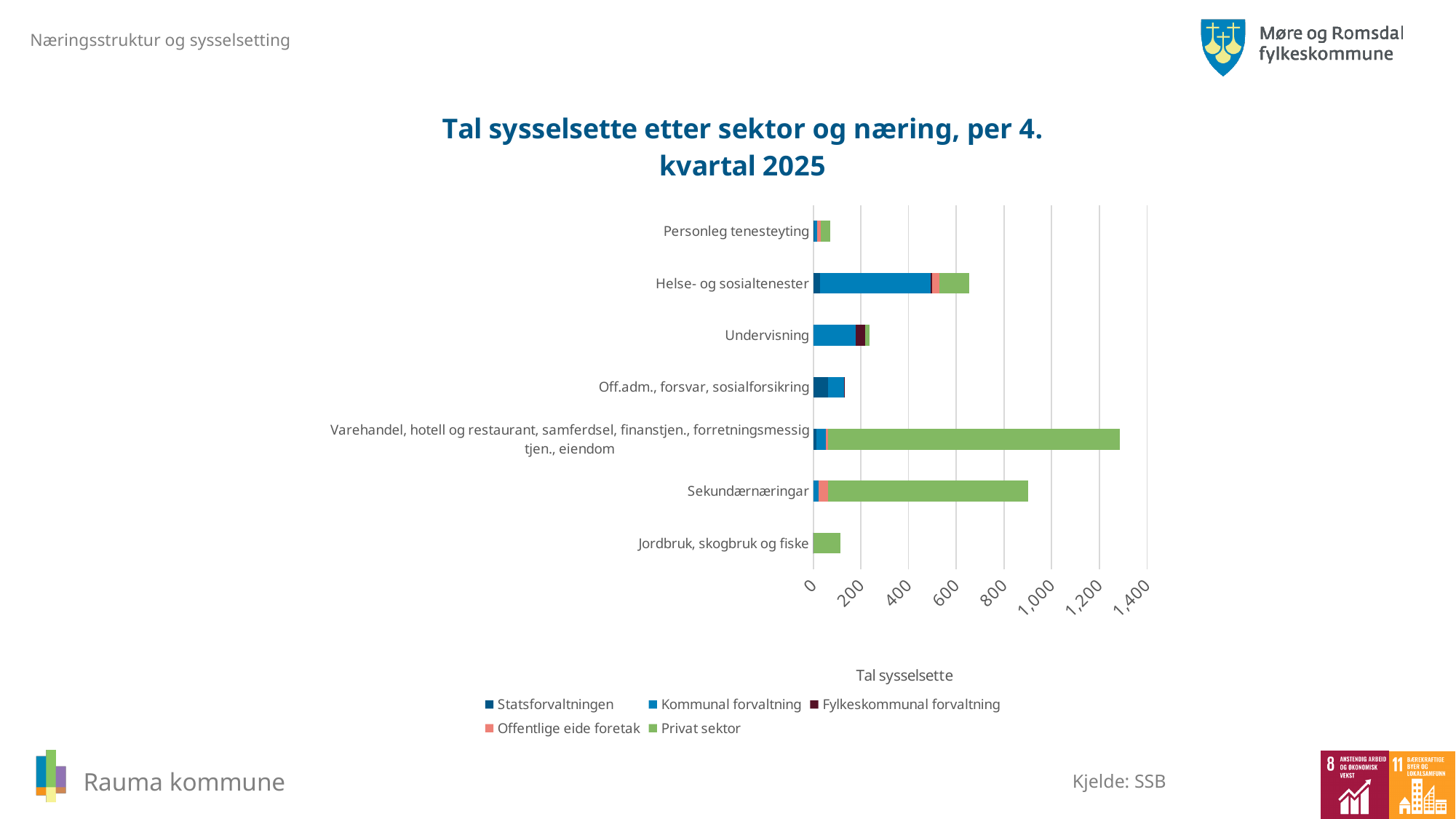
What kind of chart is shown on the slide? Stacked bar chart How many series does the legend list? 5 Which category has the shortest total bar? Personleg tenesteyting Is the total value for Undervisning greater or less than 400? less Which category has the longest total bar? Varehandel, hotell og restaurant, samferdsel, finanstjen., forretningsmessig tjen., eiendom How many categories (næringar) are shown on the y axis of the chart? 7 Is the total value for Helse- og sosialtenester greater or less than 800? less Which has the larger total bar, Sekundærnæringar or Helse- og sosialtenester? Sekundærnæringar What is the title of the chart? Tal sysselsette etter sektor og næring, per 4. kvartal 2025 Is the total value for Sekundærnæringar greater or less than 800? greater What is the label on the x axis of the chart? Tal sysselsette